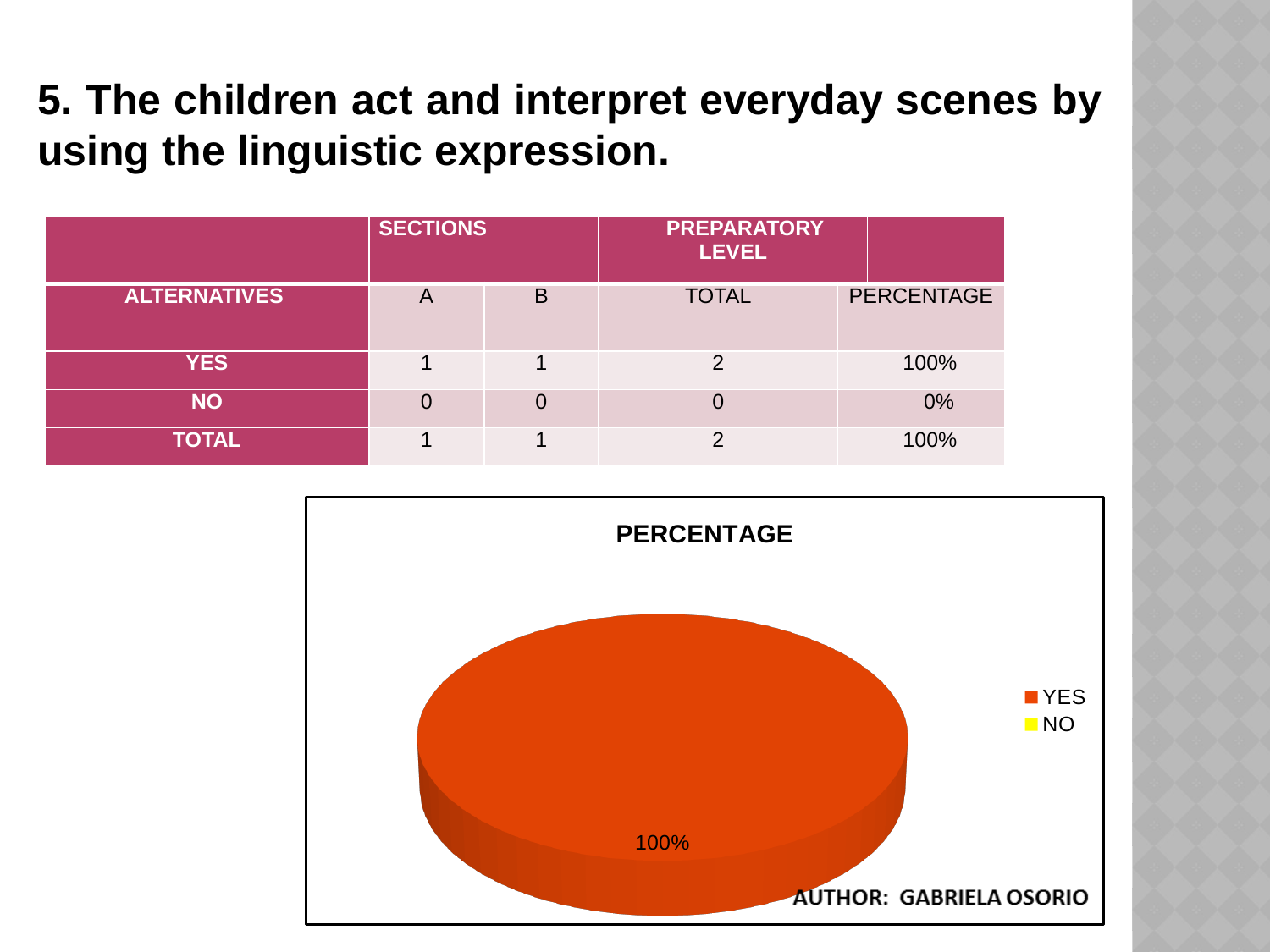
What is the title of the chart? PERCENTAGE Which is larger in the pie chart, YES or NO? YES Which category has the smallest share of the pie? NO Which category has the largest slice of the pie? YES How many entries does the chart's legend list? 2 What share of the pie does the YES slice take? 100% What data label is printed on the pie chart? 100% What colour is the YES slice in the pie chart? orange-red What kind of chart is shown on the slide? pie chart